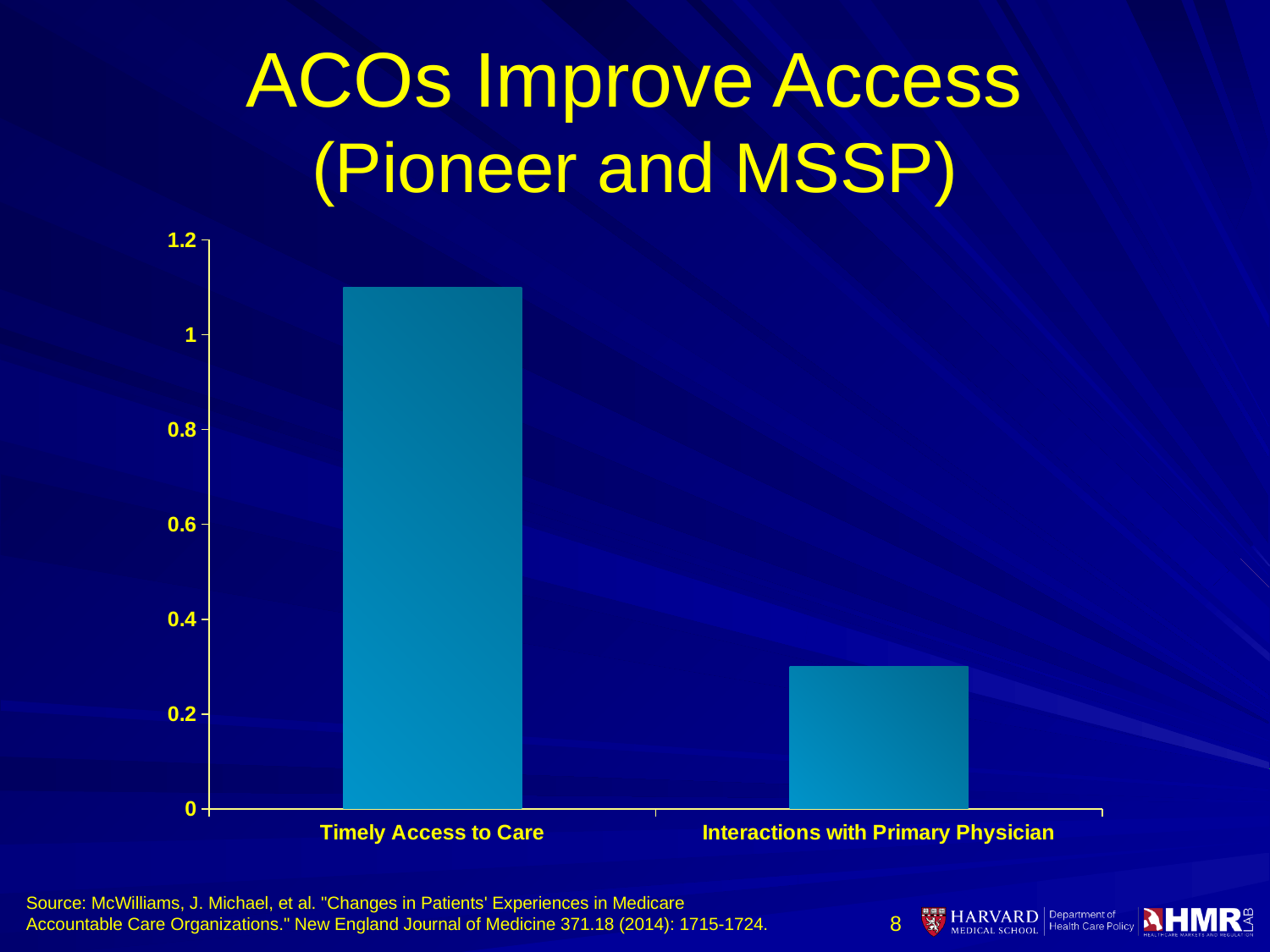
Is the value for Interactions with Primary Physician greater or less than 0.4? less Is the value for Interactions with Primary Physician greater or less than 0.2? greater What is the highest value shown on the vertical axis? 1.2 What is the title of the slide containing the chart? ACOs Improve Access (Pioneer and MSSP) Is the value for Timely Access to Care greater or less than 1.2? less Which category has the highest value? Timely Access to Care How many categories are plotted in the chart? 2 Which category has the lowest value? Interactions with Primary Physician What kind of chart is shown on the slide? bar chart Which is larger, the value for Timely Access to Care or the value for Interactions with Primary Physician? Timely Access to Care